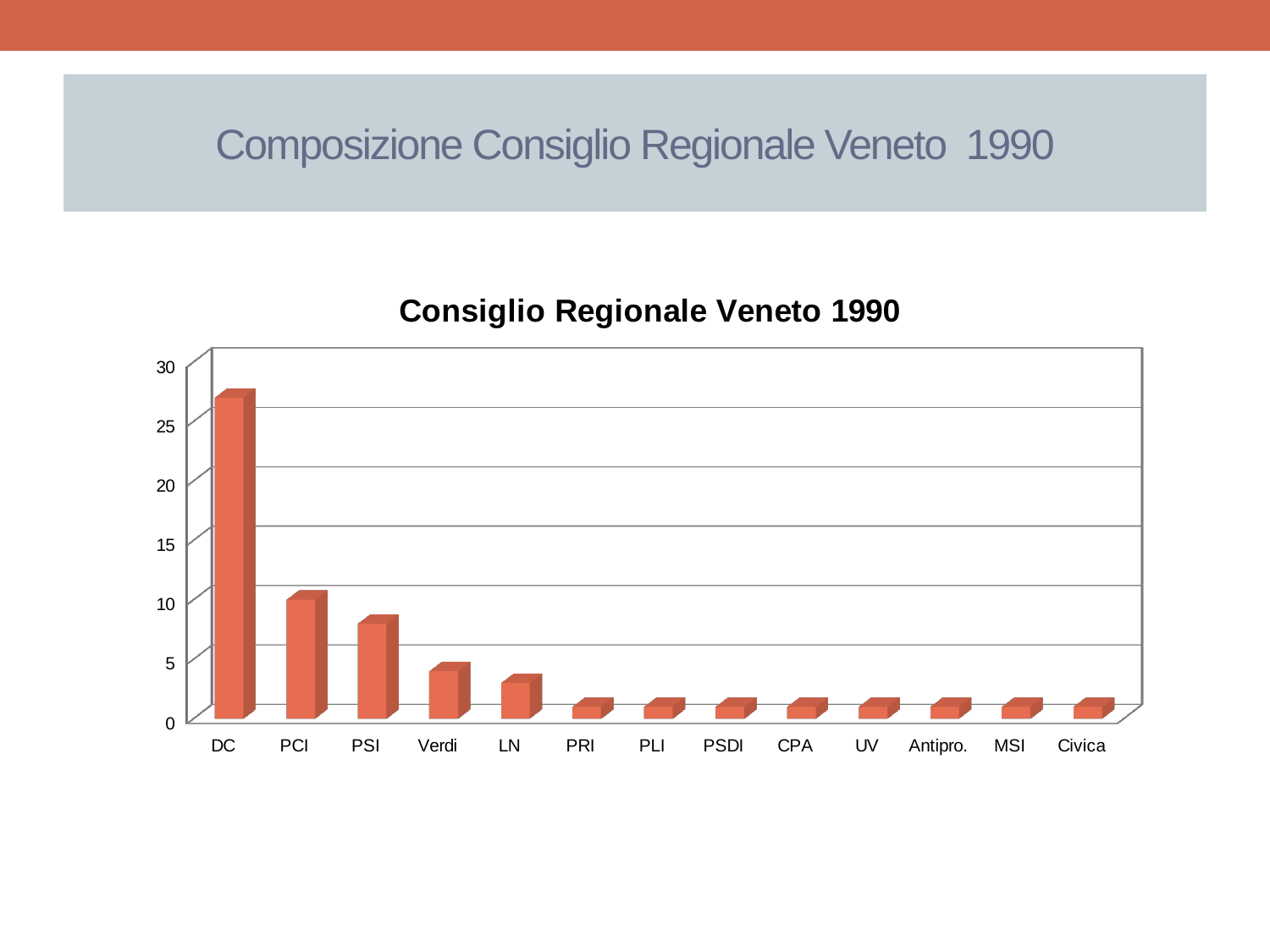
How many categories (parties) are shown on the x axis of the chart? 13 Is the value for PCI greater or less than 15? less Which has a larger value, DC or PCI? DC What kind of chart is shown on the slide? Bar chart Which has a larger value, PSI or Verdi? PSI Is the value for PSI greater or less than 10? less Is the value for DC greater or less than 25? greater Which category has the highest value in the chart? DC What is the title of the chart? Consiglio Regionale Veneto 1990 Do the values generally rise or fall moving from left to right along the x axis? Fall